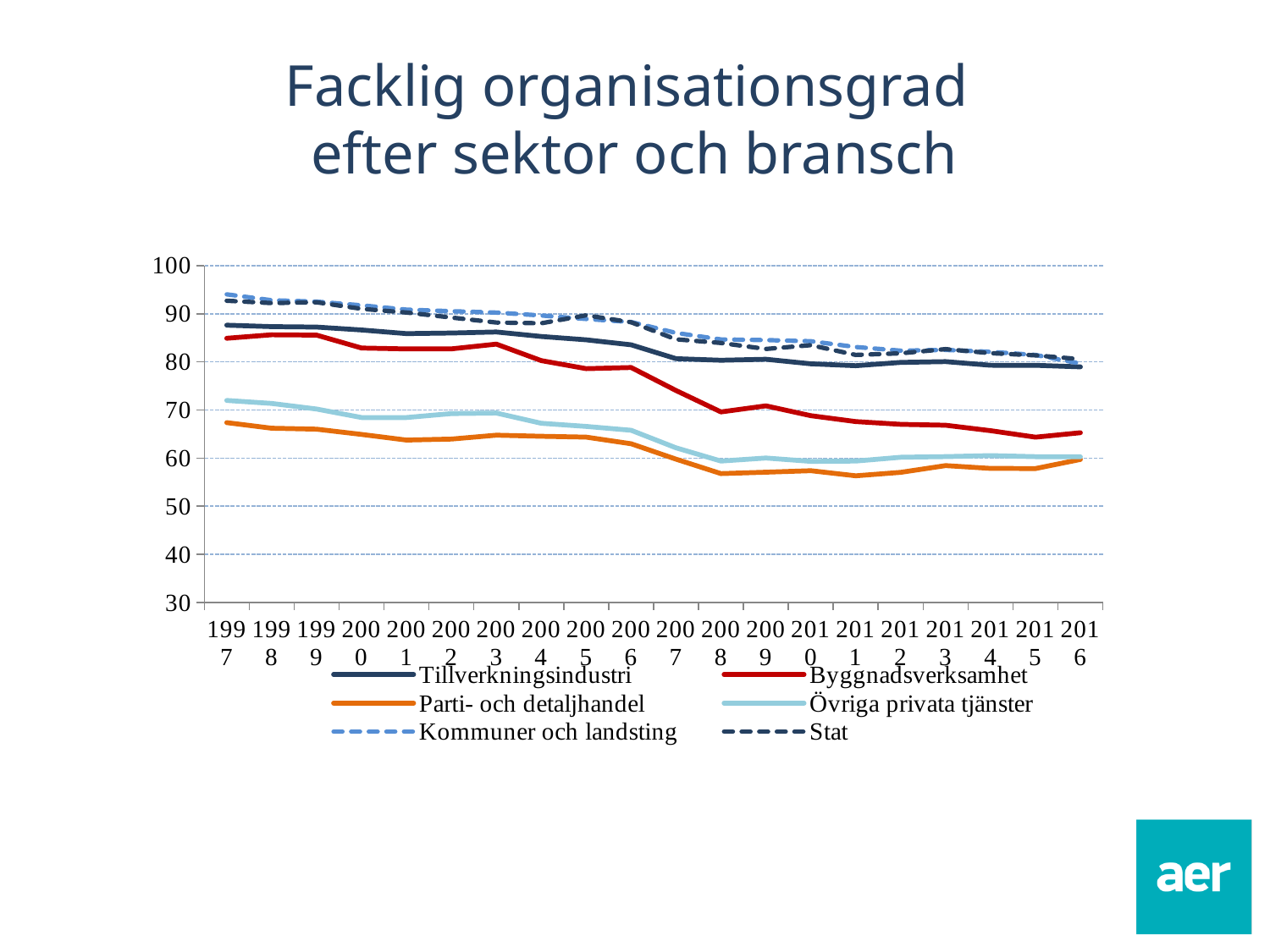
What is the title of the chart on the slide? Facklig organisationsgrad efter sektor och bransch Is the value for Parti- och detaljhandel in 2008 greater or less than 60? less What kind of chart is shown on the slide? line chart Which series is drawn with a red solid line? Byggnadsverksamhet Is the value for Kommuner och landsting in 1997 greater or less than 90? greater Is the value for Byggnadsverksamhet in 2016 greater or less than 60? greater In 2000, which is larger: Kommuner och landsting or Tillverkningsindustri? Kommuner och landsting Does the value for Byggnadsverksamhet rise or fall from 1997 to 2016? fall In 2016, which is larger: Byggnadsverksamhet or Parti- och detaljhandel? Byggnadsverksamhet How many years are plotted along the x axis? 20 How many series does the legend list? 6 Which series has the lowest value in 1997? Parti- och detaljhandel